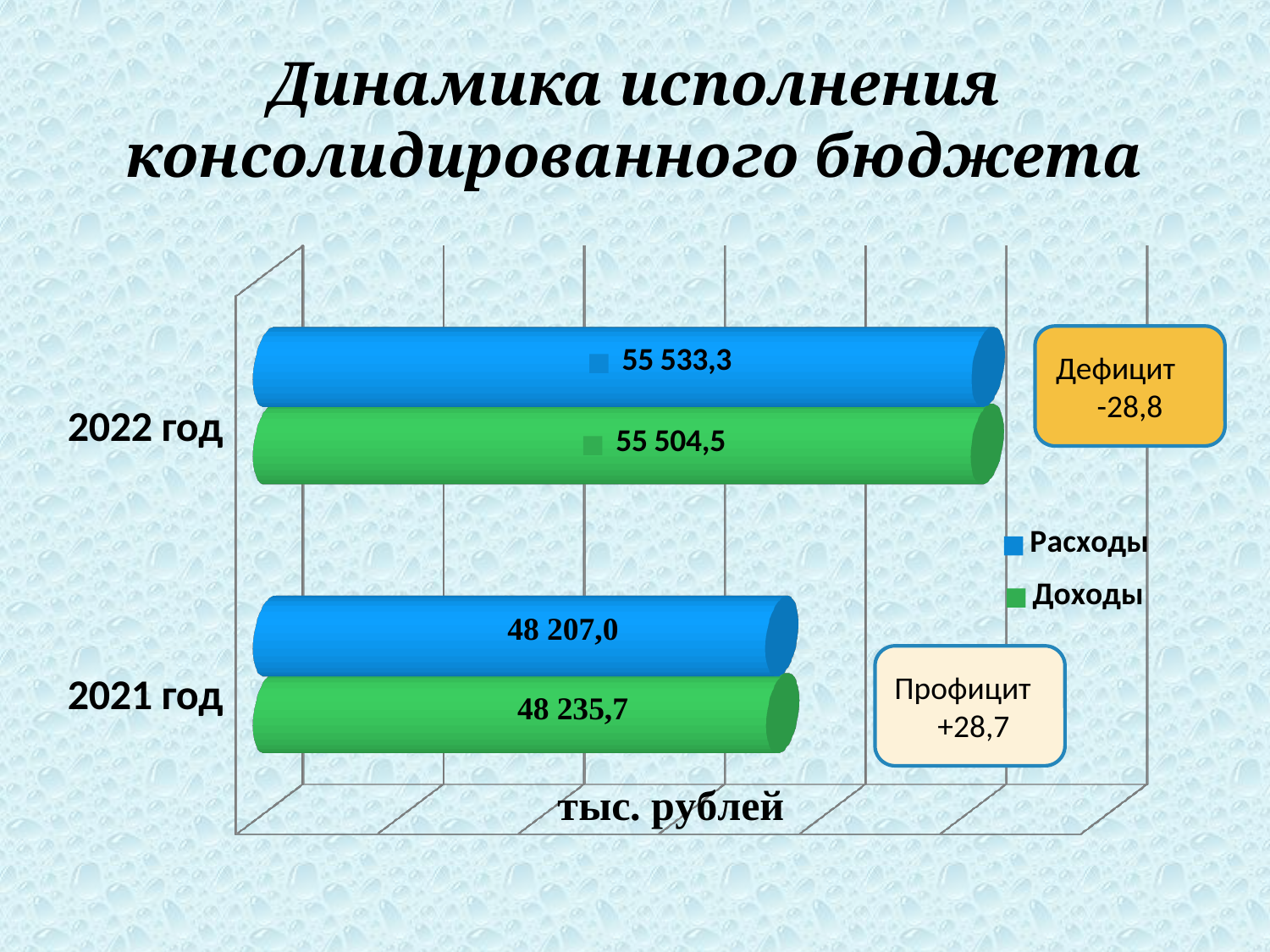
What is the value of Доходы for 2022 год? 55 504,5 How many year categories are shown on the chart? 2 What is the value of Доходы for 2021 год? 48 235,7 What type of chart is shown on the slide? bar chart How many series does the legend list? 2 What is the difference between Доходы and Расходы for 2021 год? 28,7 Which year has the lower value for Расходы? 2021 год What is the difference between Расходы and Доходы for 2022 год? 28,8 What is the value of Расходы for 2021 год? 48 207,0 What unit is given on the chart's axis label? тыс. рублей Which year has the higher value for Доходы? 2022 год What is the value of Расходы for 2022 год? 55 533,3